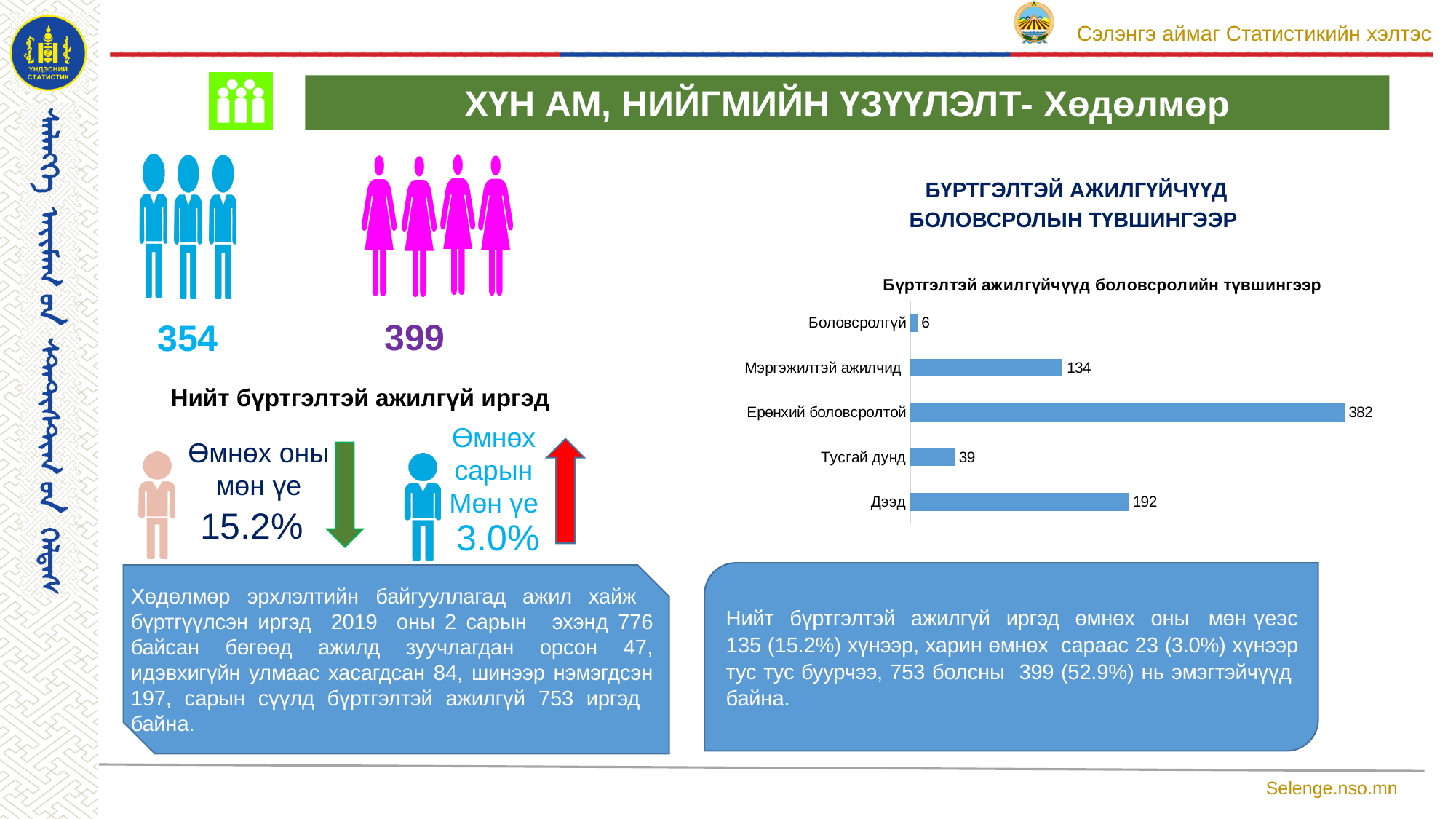
What is the value for Боловсролгүй in the chart? 6 What is the difference between the values for Мэргэжилтэй ажилчид and Тусгай дунд? 95 What kind of chart is shown on the slide? Bar chart Which category has the highest value in the chart? Ерөнхий боловсролтой What is the value for Мэргэжилтэй ажилчид in the chart? 134 What is the value for Дээд in the chart? 192 Which is larger, the value for Дээд or the value for Мэргэжилтэй ажилчид? Дээд What is the difference between the values for Ерөнхий боловсролтой and Дээд? 190 What is the value for Ерөнхий боловсролтой in the chart? 382 Which category has the lowest value in the chart? Боловсролгүй What is the value for Тусгай дунд in the chart? 39 How many categories are shown in the chart? 5